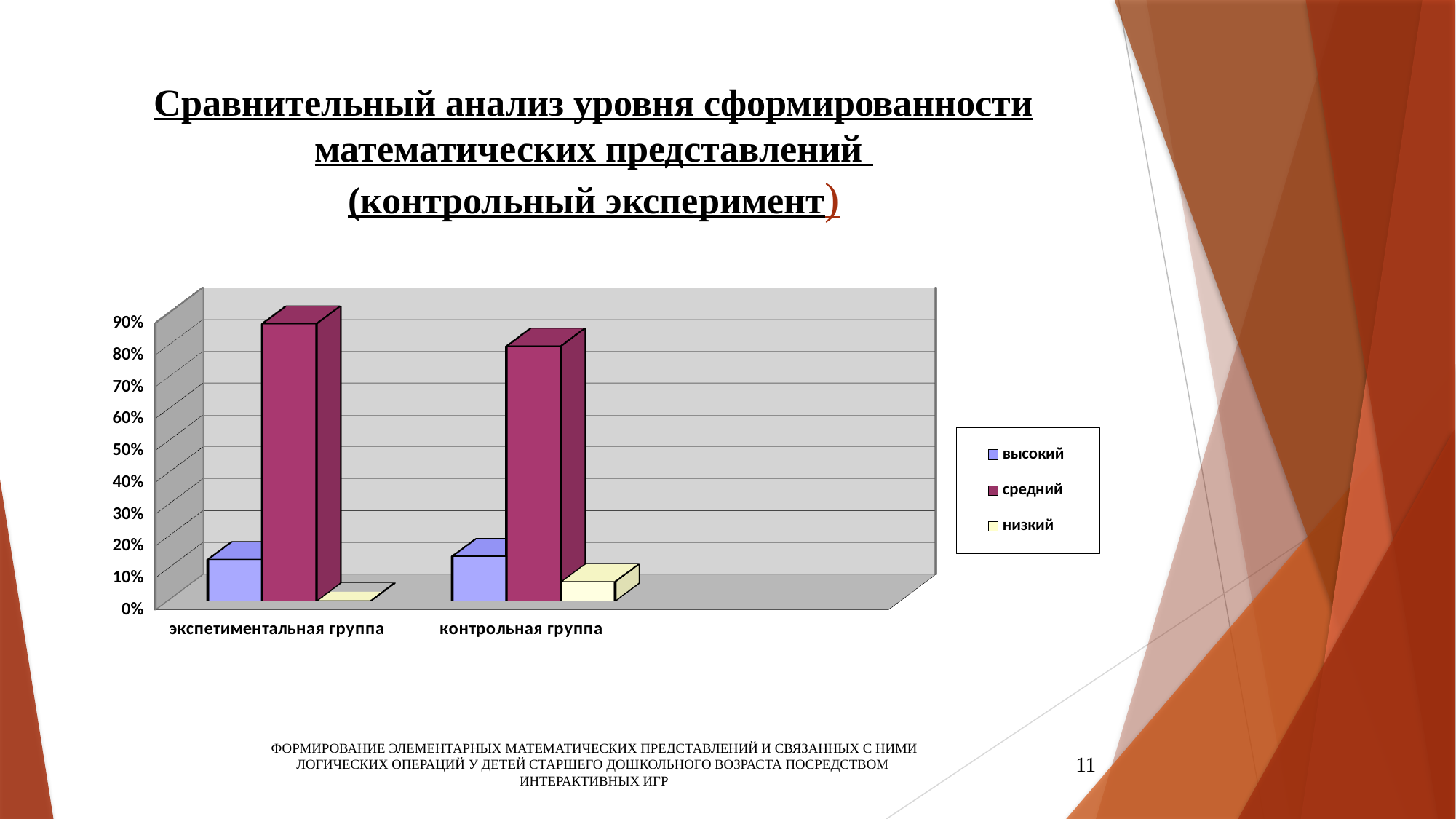
Is the value for средний in the экспетиментальная группа greater or less than 80%? greater How many groups (categories) are shown on the x axis? 2 Is the value for средний in the контрольная группа greater or less than 70%? greater Which group has the larger value for средний: экспетиментальная группа or контрольная группа? экспетиментальная группа Which group has the larger value for низкий: экспетиментальная группа or контрольная группа? контрольная группа Which level has the highest value for the экспетиментальная группа? средний Which level has the lowest value for the контрольная группа? низкий What kind of chart is shown on the slide? bar chart How many series does the legend list? 3 Which level has the lowest value for the экспетиментальная группа? низкий Which level has the highest value for the контрольная группа? средний Is the value for высокий in the экспетиментальная группа greater or less than 20%? less